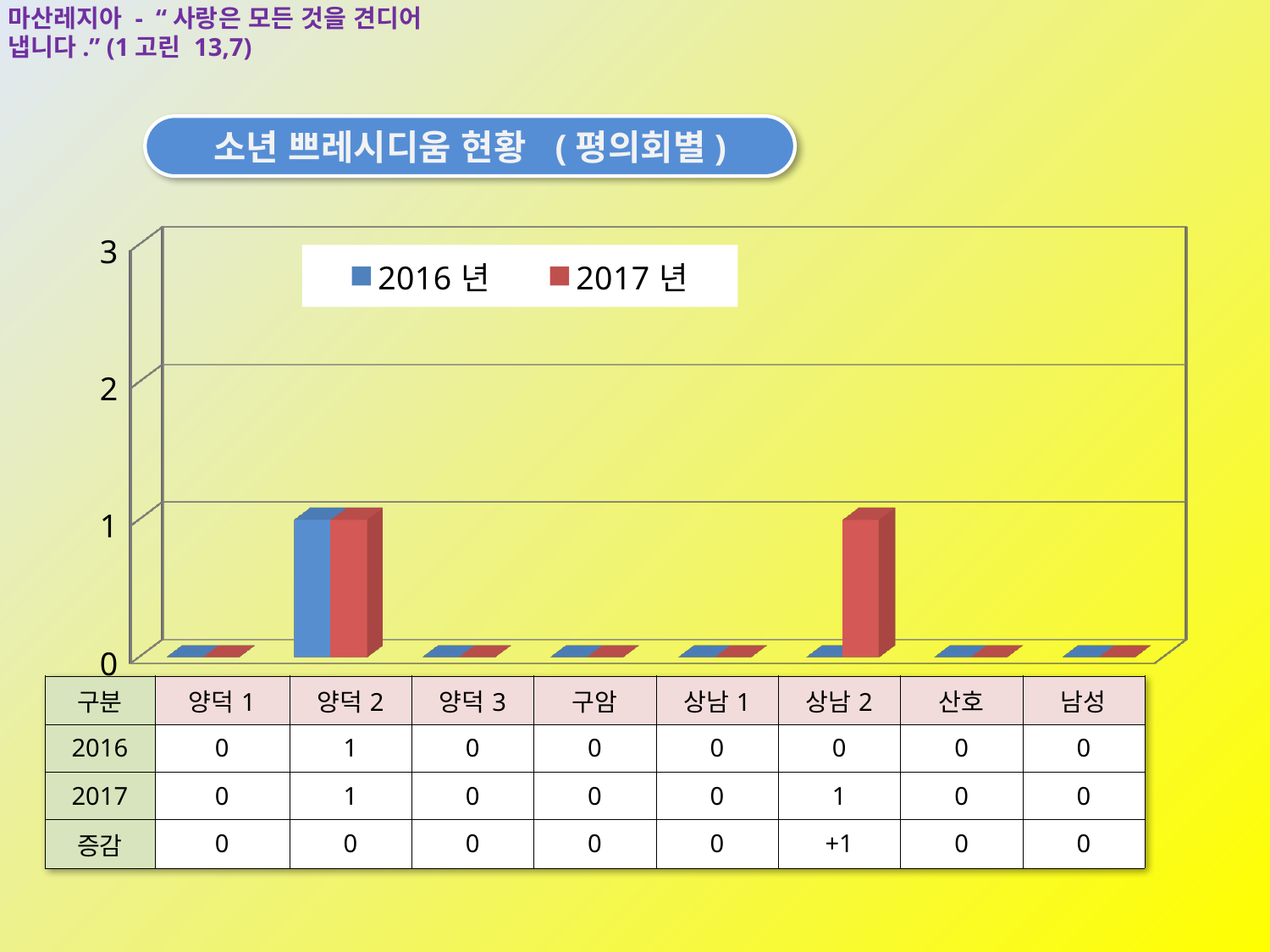
What is the value for 상남 2 in the 2017 년 series? 1 What is the value for 구암 in the 2017 년 series? 0 Which is larger for 상남 2: the 2016 년 value or the 2017 년 value? 2017 년 Which category has the highest value in the 2016 년 series? 양덕 2 What is the title of the chart? 소년 쁘레시디움 현황 (평의회별) What is the value for 상남 2 in the 2016 년 series? 0 How many series does the chart legend list? 2 What is the total of the 2017 년 values across all categories? 2 How many categories are shown on the x axis of the chart? 8 What is the value for 양덕 2 in the 2016 년 series? 1 What is the difference between the 2017 년 and 2016 년 values for 상남 2? 1 What kind of chart is shown on the slide? bar chart